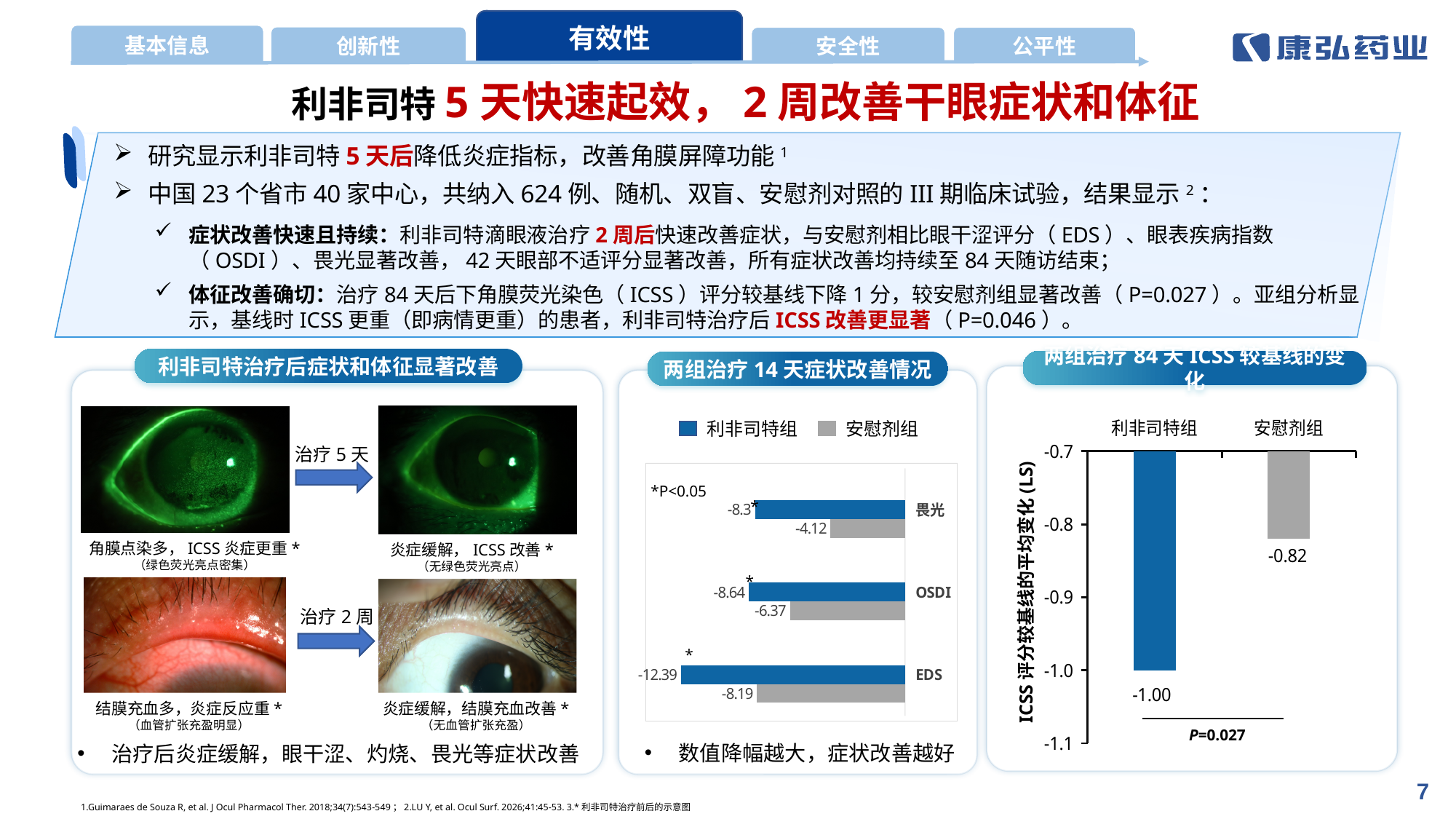
In the chart titled 两组治疗14天症状改善情况, how many series does the legend list? 2 In the chart titled 两组治疗14天症状改善情况, what is the value for 利非司特组 for EDS? -12.39 In the chart titled 两组治疗84天ICSS较基线的变化, which group shows the larger decrease from baseline? 利非司特组 In the chart titled 两组治疗14天症状改善情况, what kind of chart is it? Bar chart In the chart titled 两组治疗84天ICSS较基线的变化, what is the value for 利非司特组? -1.00 In the chart titled 两组治疗14天症状改善情况, for which category does 利非司特组 show the largest decrease? EDS In the chart titled 两组治疗14天症状改善情况, how many symptom categories are shown? 3 In the chart titled 两组治疗14天症状改善情况, what is the value for 安慰剂组 for OSDI? -6.37 In the chart titled 两组治疗14天症状改善情况, what is the difference between the 利非司特组 and 安慰剂组 values for EDS? 4.20 In the chart titled 两组治疗14天症状改善情况, what is the value for 安慰剂组 for 畏光? -4.12 In the chart titled 两组治疗84天ICSS较基线的变化, what is the value for 安慰剂组? -0.82 In the chart titled 两组治疗84天ICSS较基线的变化, what P value is shown? P=0.027